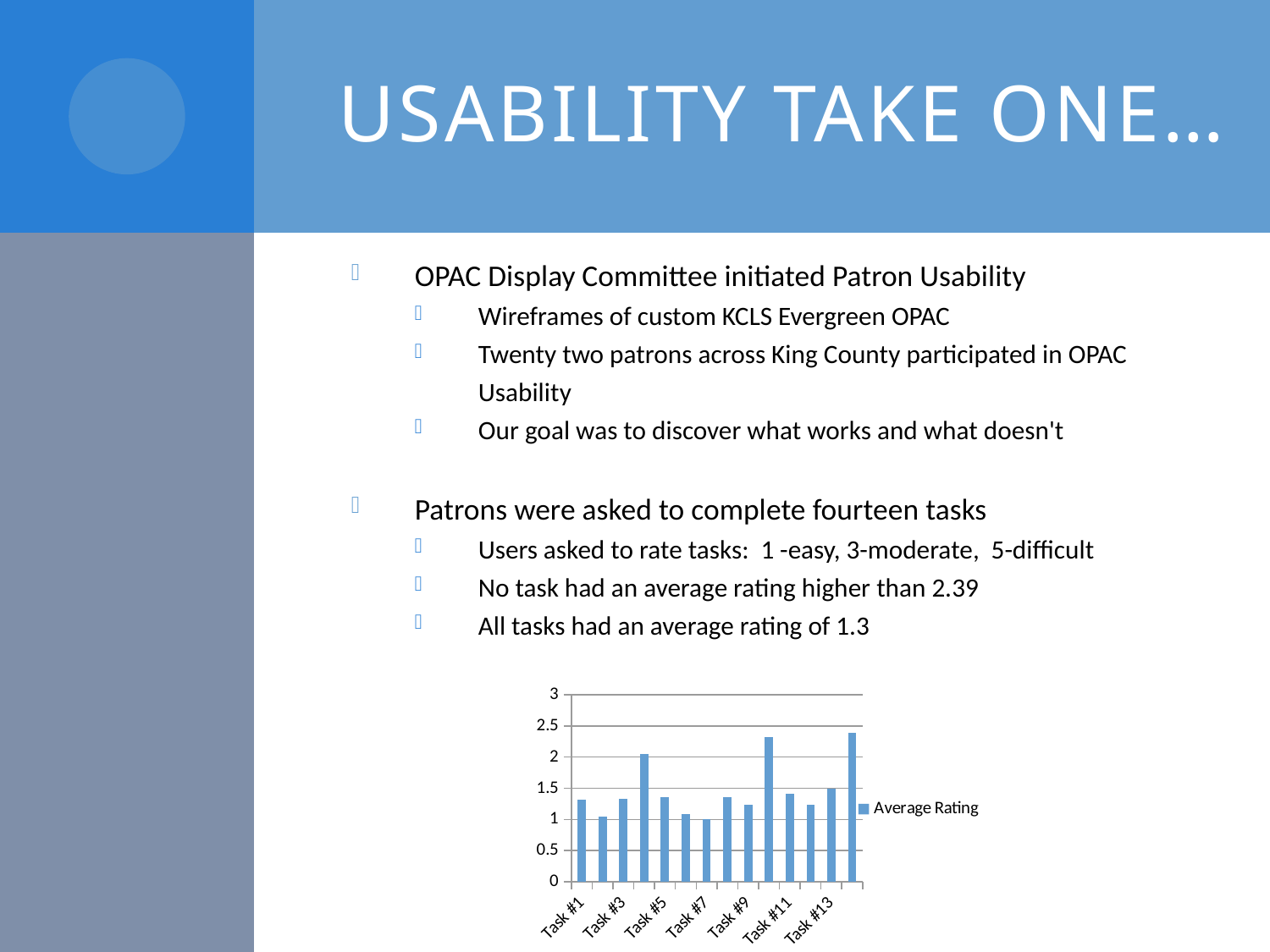
Is the value for Task #11 greater or less than 1? greater What is the name of the series shown in the chart's legend? Average Rating How many bars (tasks) are plotted in the chart? 14 Which has the higher average rating, Task #13 or Task #7? Task #13 Is the value for Task #13 greater or less than 2? less Is the value for Task #3 greater or less than 2? less What is the highest value shown on the chart's vertical axis? 3 What kind of chart is shown on the slide? bar chart Which has the higher average rating, Task #11 or Task #7? Task #11 How many series does the chart's legend list? 1